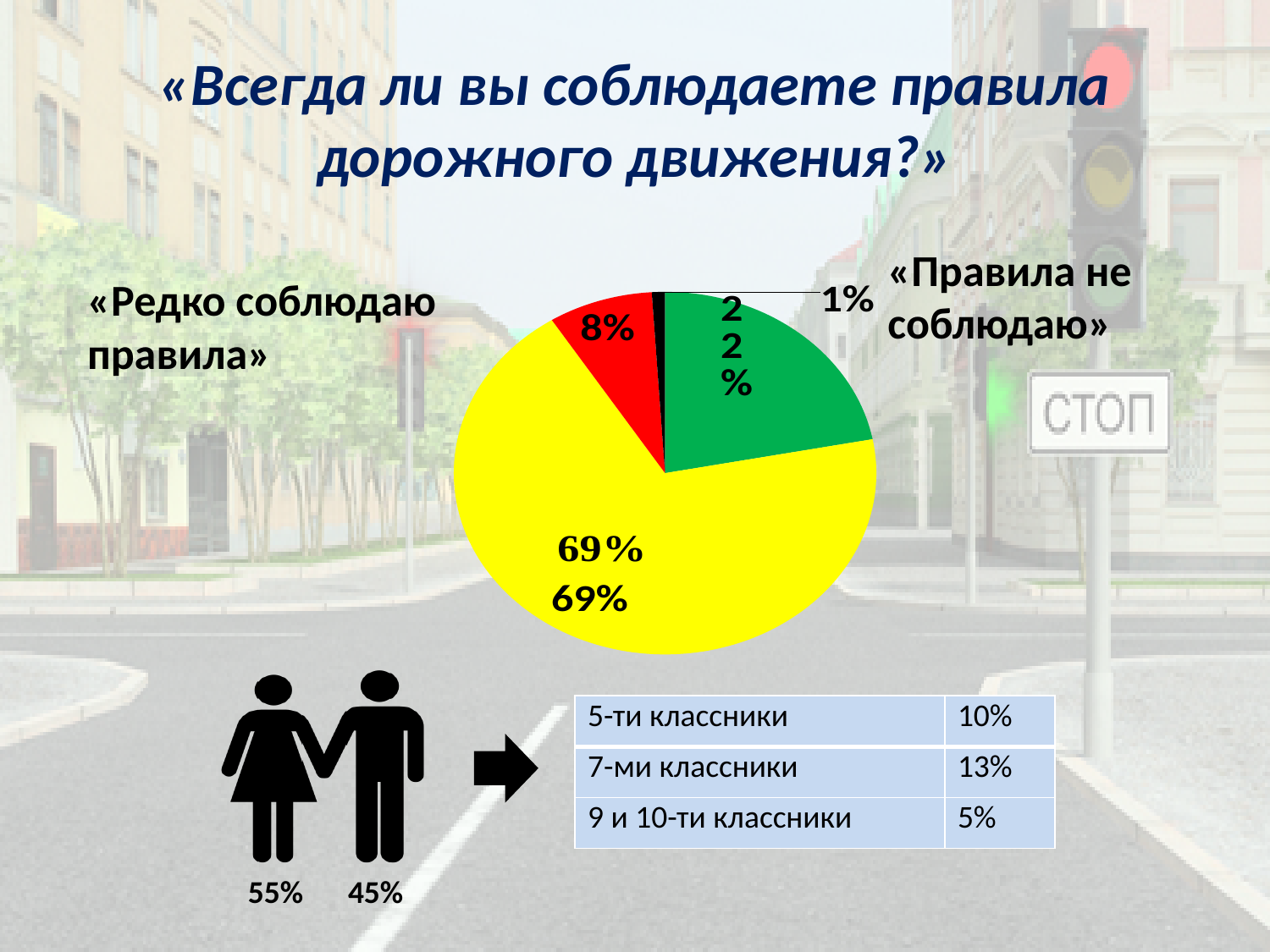
Is the value of the green slice greater or less than 50%? less What is the value of the smallest slice of the pie chart? 1% How many slices does the pie chart have? 4 Which slice is larger, the green one or the red one? the green one (22%) What is the difference between the yellow slice (69%) and the green slice (22%)? 47% What percentage is shown next to the label «Правила не соблюдаю»? 1% What value is labelled on the red slice of the pie chart? 8% What kind of chart is shown on the slide? pie chart What value is labelled on the green slice of the pie chart? 22% What is the value of the largest slice of the pie chart? 69% What share of the pie does the yellow slice represent? 69% What colour is the largest slice of the pie chart? yellow